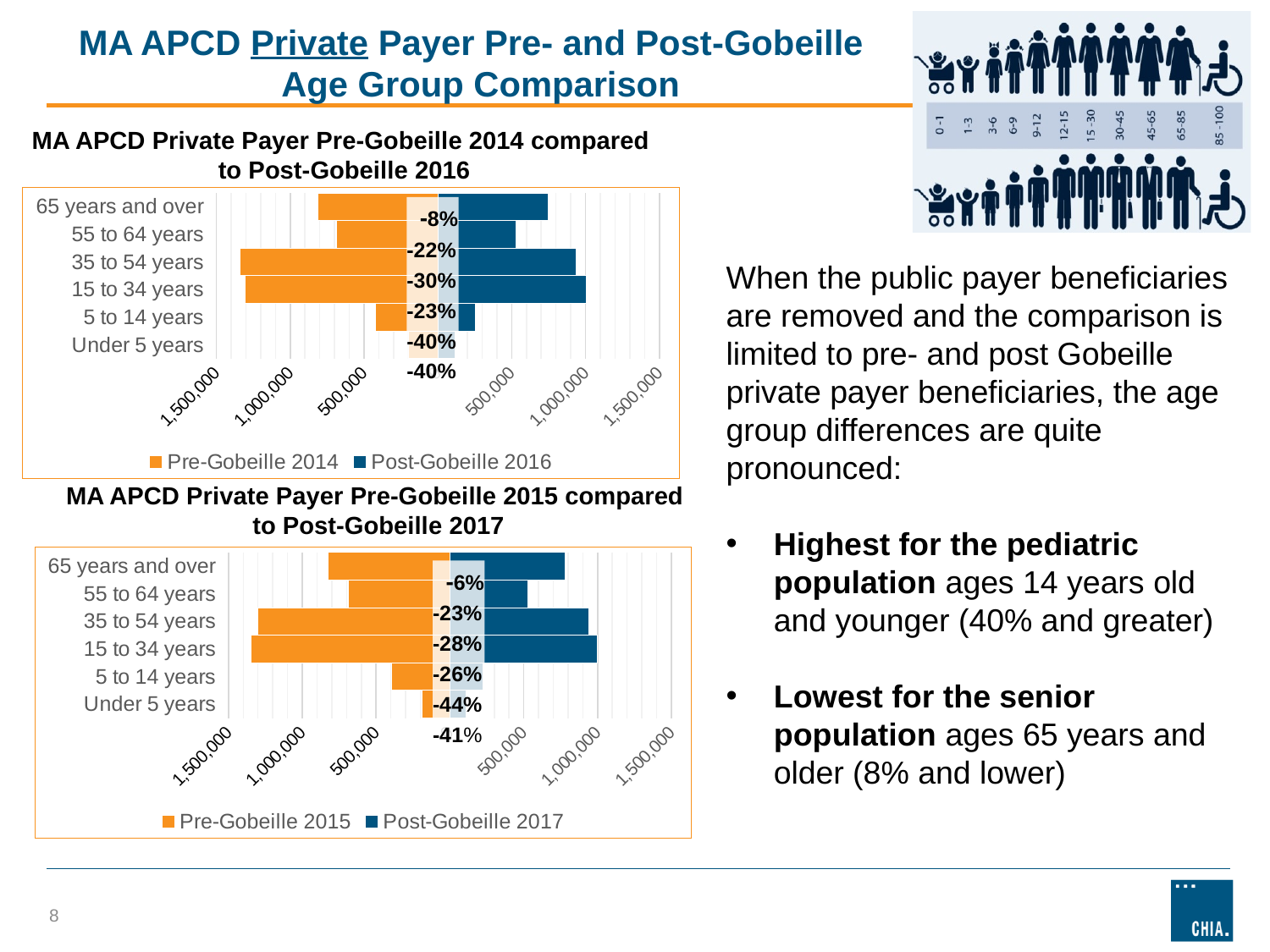
In the top chart (Pre-Gobeille 2014 compared to Post-Gobeille 2016), which age group shows the smallest percentage decrease? 65 years and over In the bottom chart (Pre-Gobeille 2015 compared to Post-Gobeille 2017), is the percentage decrease larger for 15 to 34 years or for 5 to 14 years? 5 to 14 years What type of chart is the bottom chart (Pre-Gobeille 2015 compared to Post-Gobeille 2017)? Bar chart In the bottom chart (Pre-Gobeille 2015 compared to Post-Gobeille 2017), what percentage change is shown for the 35 to 54 years age group? -28% In the top chart (Pre-Gobeille 2014 compared to Post-Gobeille 2016), is the Pre-Gobeille 2014 value for 35 to 54 years greater or less than 1,000,000? greater In the top chart (Pre-Gobeille 2014 compared to Post-Gobeille 2016), what percentage change is shown for the 15 to 34 years age group? -23% In the top chart (Pre-Gobeille 2014 compared to Post-Gobeille 2016), is the Post-Gobeille 2016 value for 5 to 14 years greater or less than 500,000? less In the bottom chart (Pre-Gobeille 2015 compared to Post-Gobeille 2017), which age group shows the largest percentage decrease? 5 to 14 years In the bottom chart (Pre-Gobeille 2015 compared to Post-Gobeille 2017), what percentage change is shown for the Under 5 years age group? -41% In the top chart (Pre-Gobeille 2014 compared to Post-Gobeille 2016), what percentage change is shown for the 65 years and over age group? -8% How many series does the legend of the top chart (Pre-Gobeille 2014 compared to Post-Gobeille 2016) list? 2 How many age groups are shown in the bottom chart (Pre-Gobeille 2015 compared to Post-Gobeille 2017)? 6